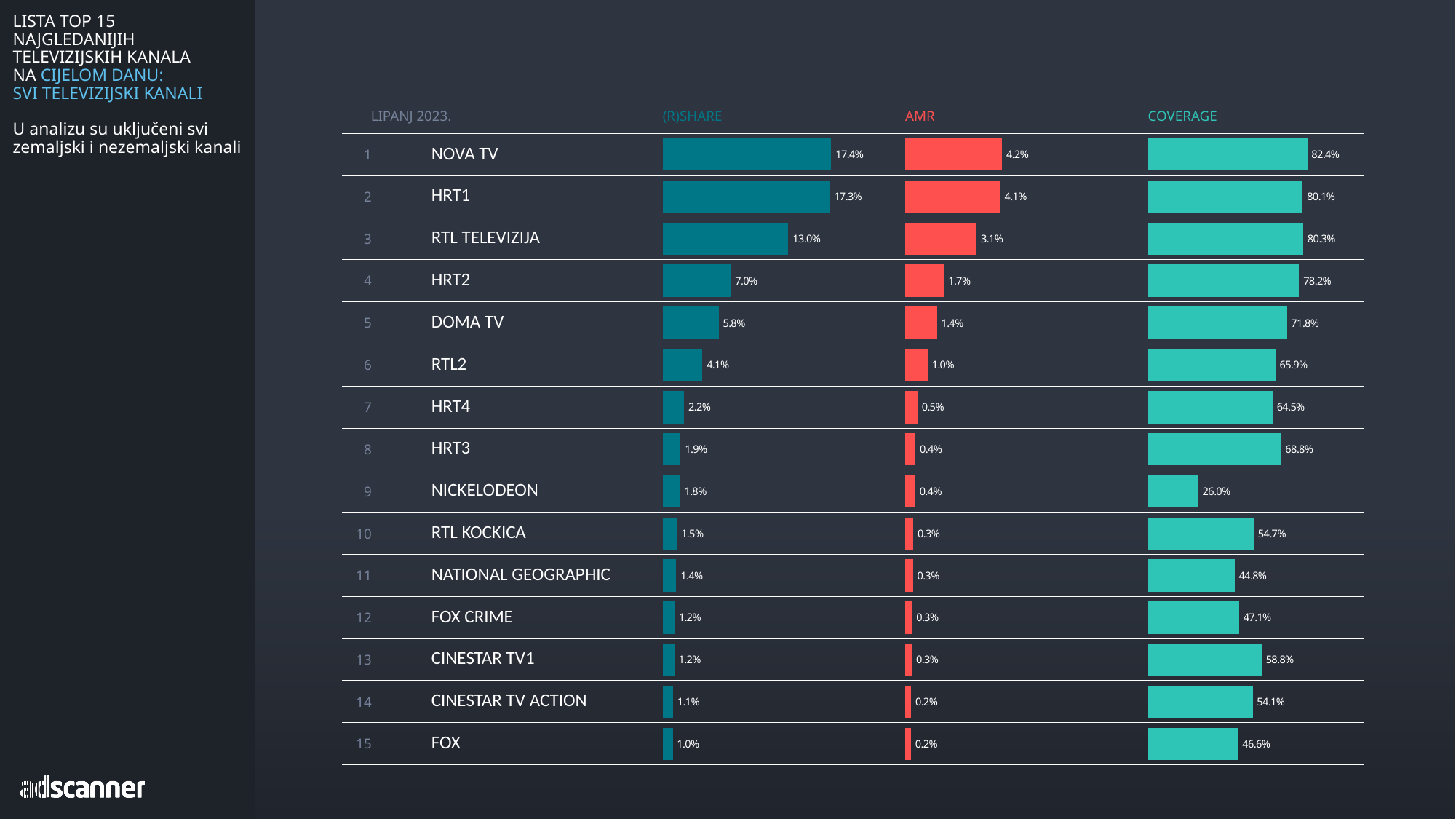
In the COVERAGE chart, which is larger: HRT3 or NICKELODEON? HRT3 Which month and year do the charts cover, according to the header? LIPANJ 2023. In the (R)SHARE chart, what is the value for NOVA TV? 17.4% In the AMR chart, which channel has the highest value? NOVA TV In the (R)SHARE chart, what is the difference between HRT2 and DOMA TV? 1.2% In the COVERAGE chart, which channel has the lowest value? NICKELODEON What kind of chart is used to show the (R)SHARE values? bar chart In the AMR chart, what is the value for RTL TELEVIZIJA? 3.1% In the COVERAGE chart, what is the difference between RTL TELEVIZIJA and HRT2? 2.1% In the COVERAGE chart, what is the value for DOMA TV? 71.8% In the (R)SHARE chart, which channel has the lowest value? FOX How many channels are listed in the charts? 15